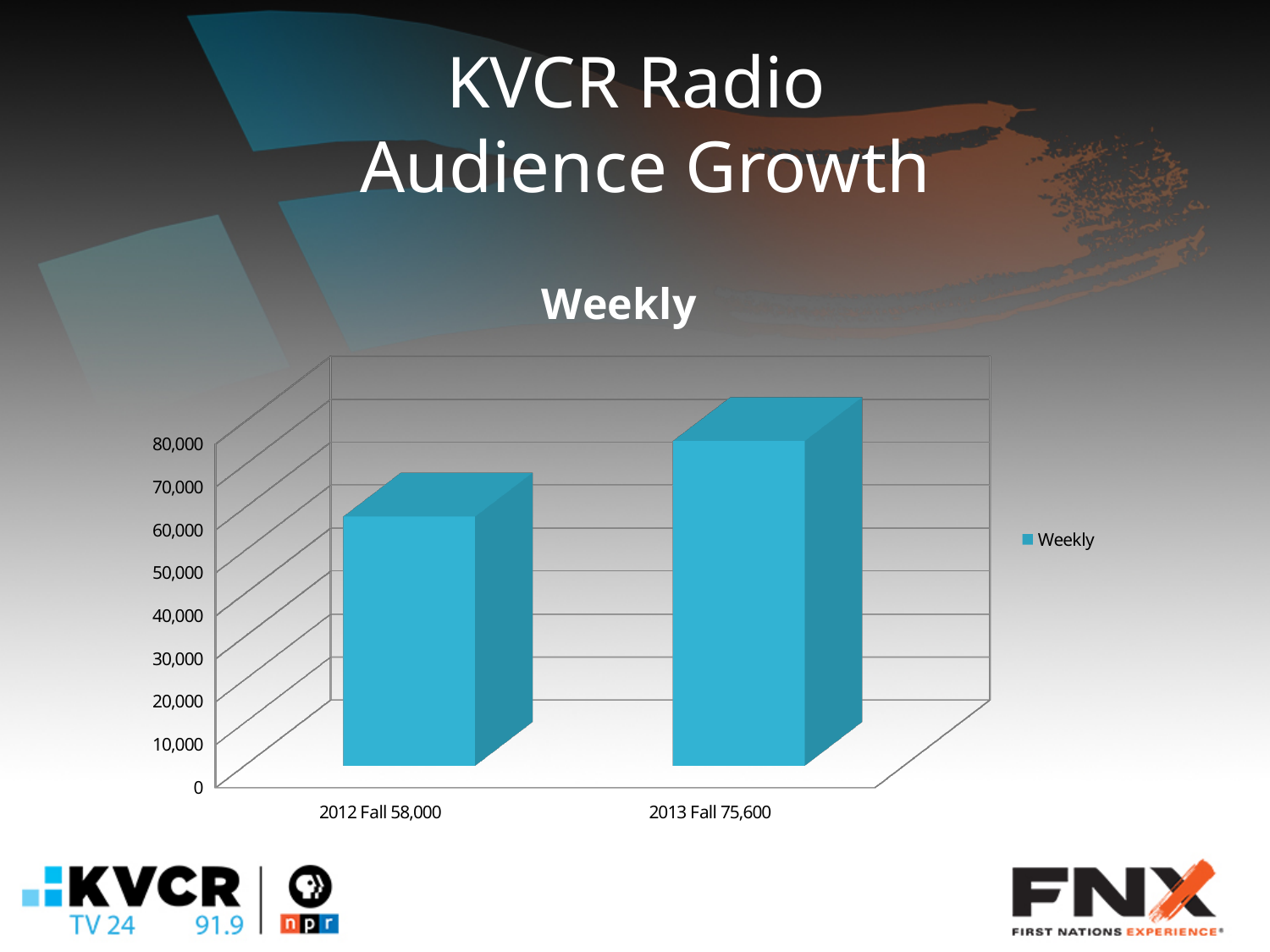
Is the weekly audience for 2013 Fall larger or smaller than for 2012 Fall? larger What kind of chart is shown on the slide? bar chart Which category has the lower weekly audience? 2012 Fall How many categories are shown on the chart? 2 Does the weekly audience rise or fall from 2012 Fall to 2013 Fall? rise Is the value for 2012 Fall greater or less than 70,000? less How many series does the legend list? 1 Which category has the higher weekly audience, 2012 Fall or 2013 Fall? 2013 Fall What is the difference between the 2013 Fall and 2012 Fall weekly audience values? 17,600 What is the weekly audience value for 2012 Fall? 58,000 Is the value for 2013 Fall greater or less than 70,000? greater What is the weekly audience value for 2013 Fall? 75,600